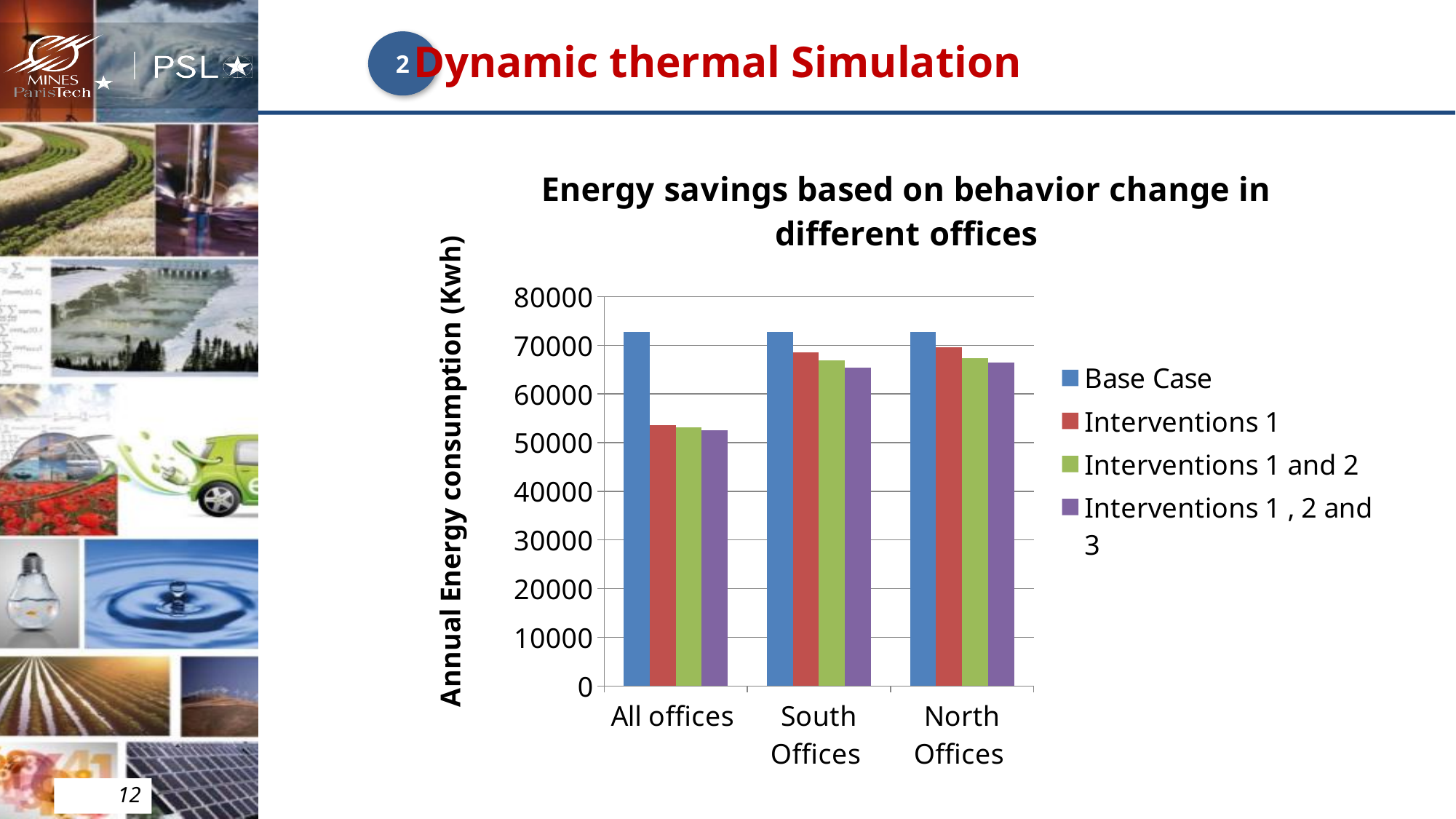
How many series does the legend list? 4 Within the All offices category, which series has the highest value? Base Case What is the title of the chart? Energy savings based on behavior change in different offices Is the Base Case value for North Offices greater or less than 70000? greater Which is larger, the Interventions 1 value for All offices or for South Offices? South Offices Is the Base Case value for All offices greater or less than 70000? greater Is the Interventions 1 value for All offices greater or less than 60000? less Which office category has the lowest Interventions 1 value? All offices What kind of chart is shown on the slide? bar chart What is the label of the vertical axis? Annual Energy consumption (Kwh) How many office categories are shown on the x axis? 3